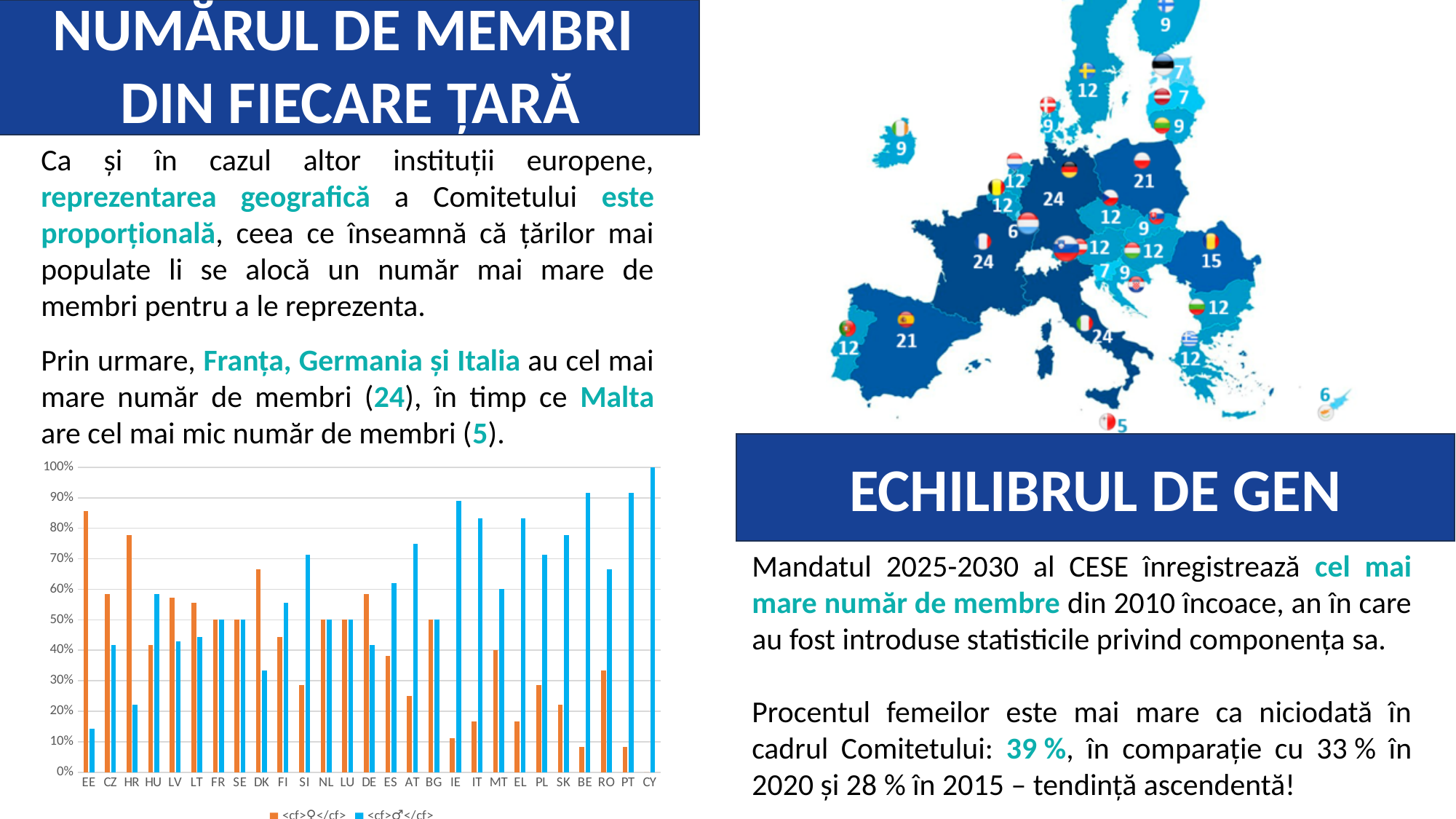
How many country categories are shown on the x axis of the bar chart? 27 In the bar chart, for IE, which bar is larger, the orange one or the blue one? blue In the bar chart, what is the value of the blue bar for CY? 100% In the bar chart, is the orange bar for EE greater or less than 80%? greater In the bar chart, for DE, which bar is larger, the orange one or the blue one? orange How many series does the legend of the bar chart list? 2 In the bar chart, which country has the highest orange bar? EE In the bar chart, which country has the lowest blue bar? EE In the bar chart, is the orange bar for IE greater or less than 20%? less In the bar chart, is the blue bar for IT greater or less than 80%? greater In the bar chart, which country has the highest blue bar? CY What kind of chart is shown at the bottom left of the slide? bar chart